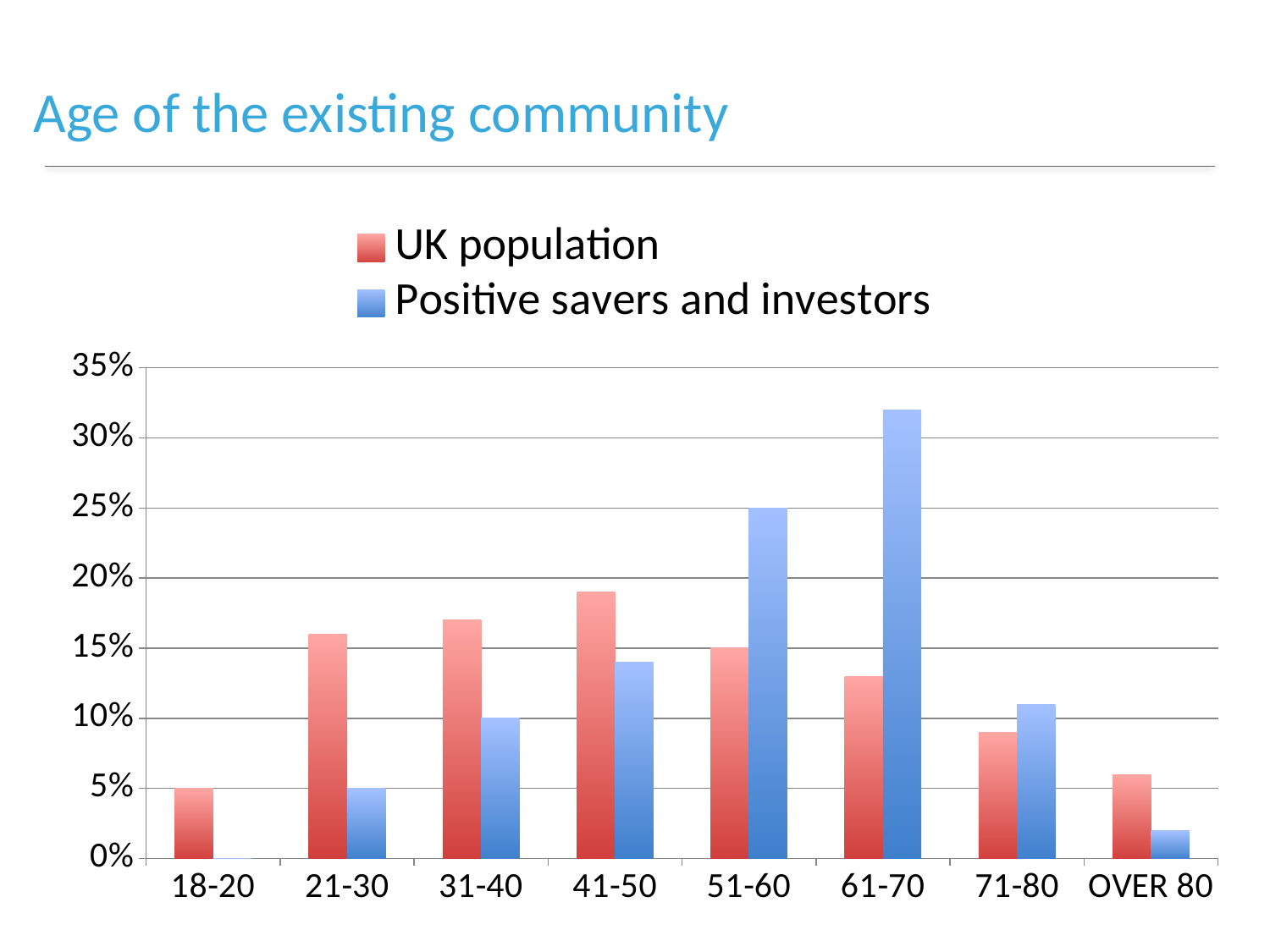
What kind of chart is shown on the slide? bar chart How many age categories are shown on the x axis? 8 Is the value for Positive savers and investors in the OVER 80 group greater or less than 5%? less In the 21-30 group, which series has the larger value, UK population or Positive savers and investors? UK population What is the title of the slide? Age of the existing community Which age group has the highest value for UK population? 41-50 Is the value for Positive savers and investors in the 61-70 group greater or less than 30%? greater Is the value for UK population in the 41-50 group greater or less than 20%? less Which age group has the lowest value for Positive savers and investors? 18-20 How many series does the legend list? 2 In the 51-60 group, which series has the larger value, UK population or Positive savers and investors? Positive savers and investors Which age group has the highest value for Positive savers and investors? 61-70